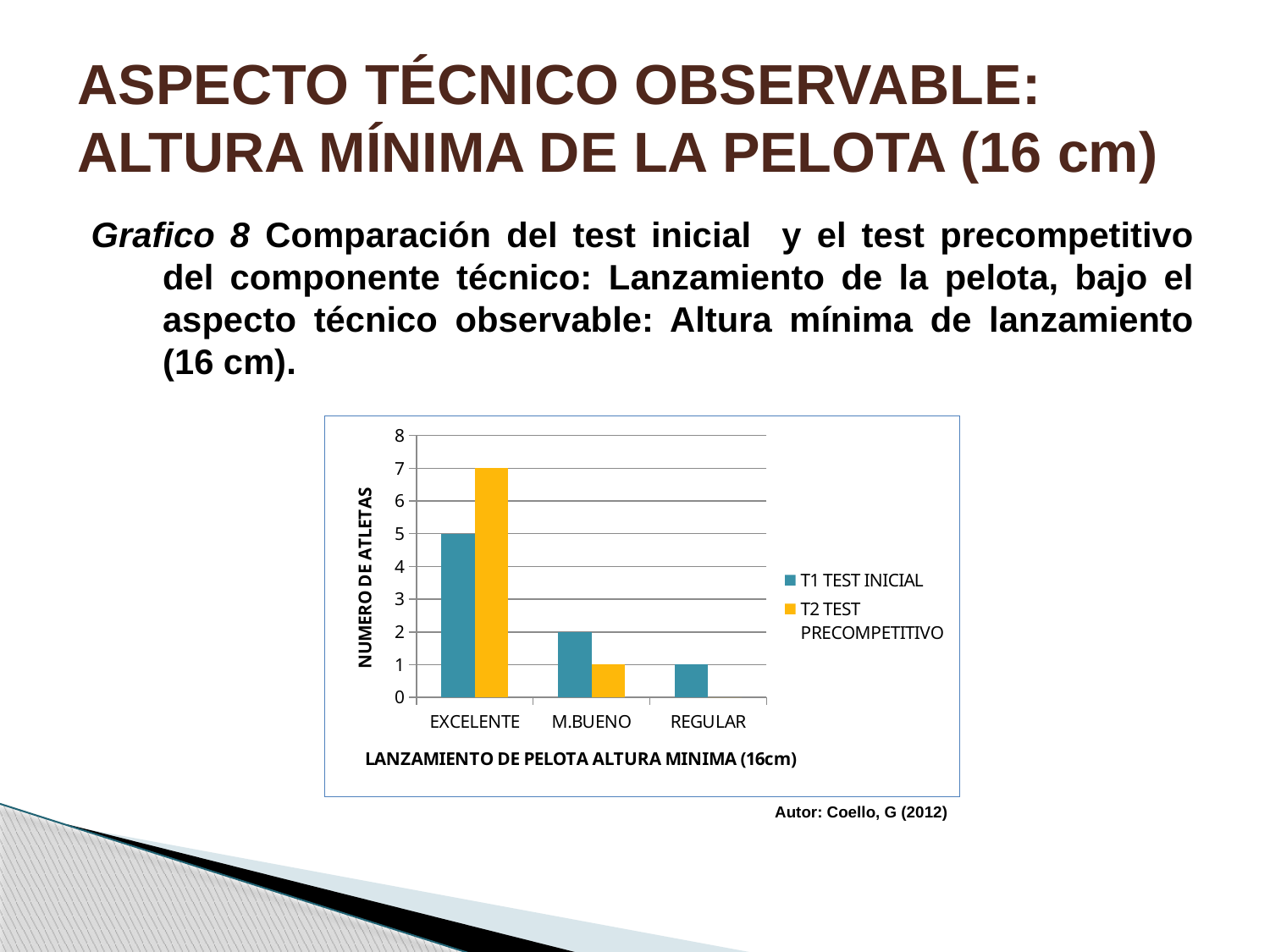
Which category has the highest value in the T2 TEST PRECOMPETITIVO series? EXCELENTE What kind of chart is shown on the slide? bar chart What is the value for M.BUENO in the T1 TEST INICIAL series? 2 What is the value for EXCELENTE in the T1 TEST INICIAL series? 5 What is the value for EXCELENTE in the T2 TEST PRECOMPETITIVO series? 7 How many categories are shown on the x axis? 3 For M.BUENO, which series has the larger value, T1 TEST INICIAL or T2 TEST PRECOMPETITIVO? T1 TEST INICIAL Which category has the lowest value in the T1 TEST INICIAL series? REGULAR What is the difference between the T2 TEST PRECOMPETITIVO and T1 TEST INICIAL values for EXCELENTE? 2 What is the label of the y axis? NUMERO DE ATLETAS How many series does the legend list? 2 What is the value for REGULAR in the T1 TEST INICIAL series? 1